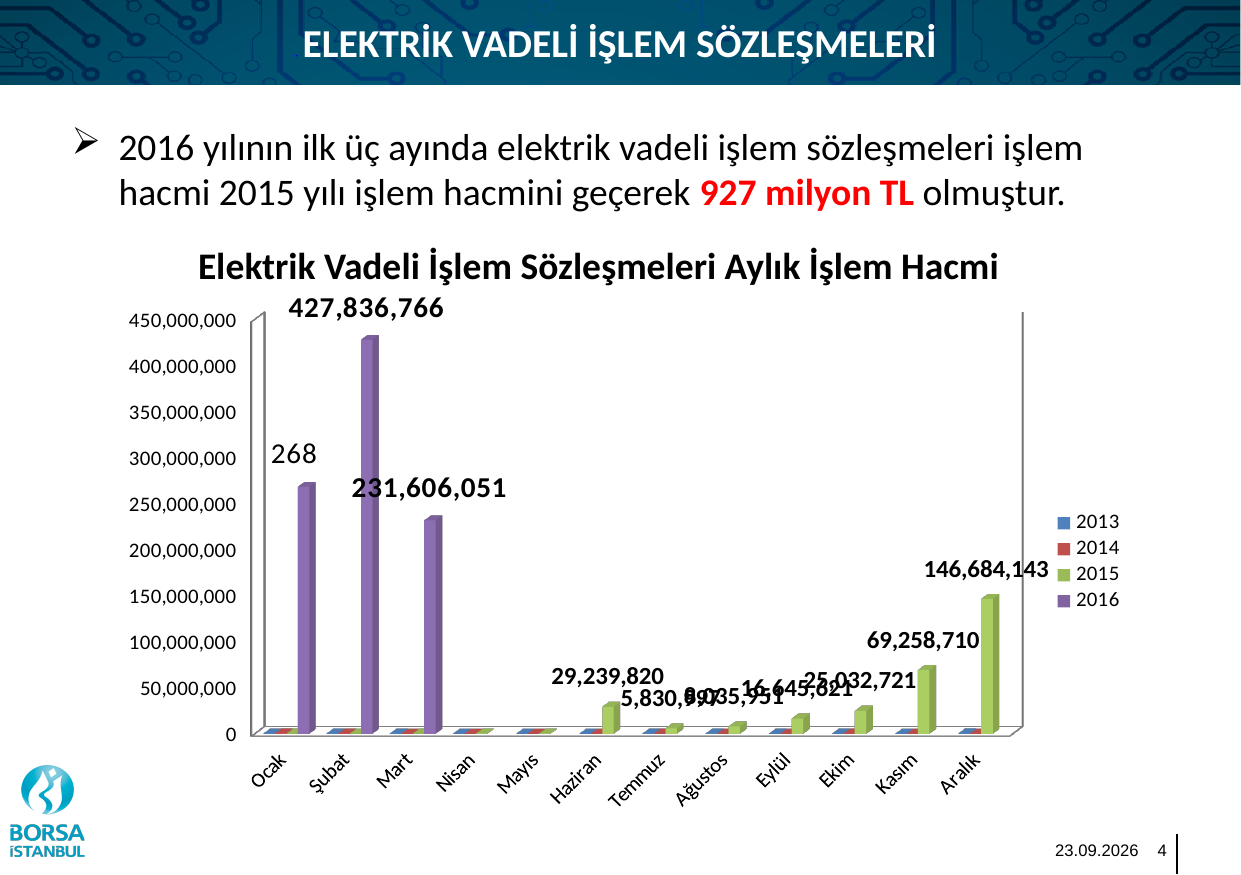
What is the 2015 value for Kasım? 69,258,710 How many series does the legend list? 4 What is the difference between the 2016 values for Şubat and Mart? 196,230,715 What is the 2015 value for Aralık? 146,684,143 What is the 2015 value for Haziran? 29,239,820 What type of chart is shown on the slide? bar chart Which is larger, the 2015 value for Aralık or the 2015 value for Kasım? Aralık What is the 2016 value for Mart? 231,606,051 Which month has the highest bar in the chart? Şubat What is the 2016 value for Şubat? 427,836,766 Is the 2016 value for Ocak greater or less than 250,000,000? greater How many months (categories) are shown on the x axis? 12